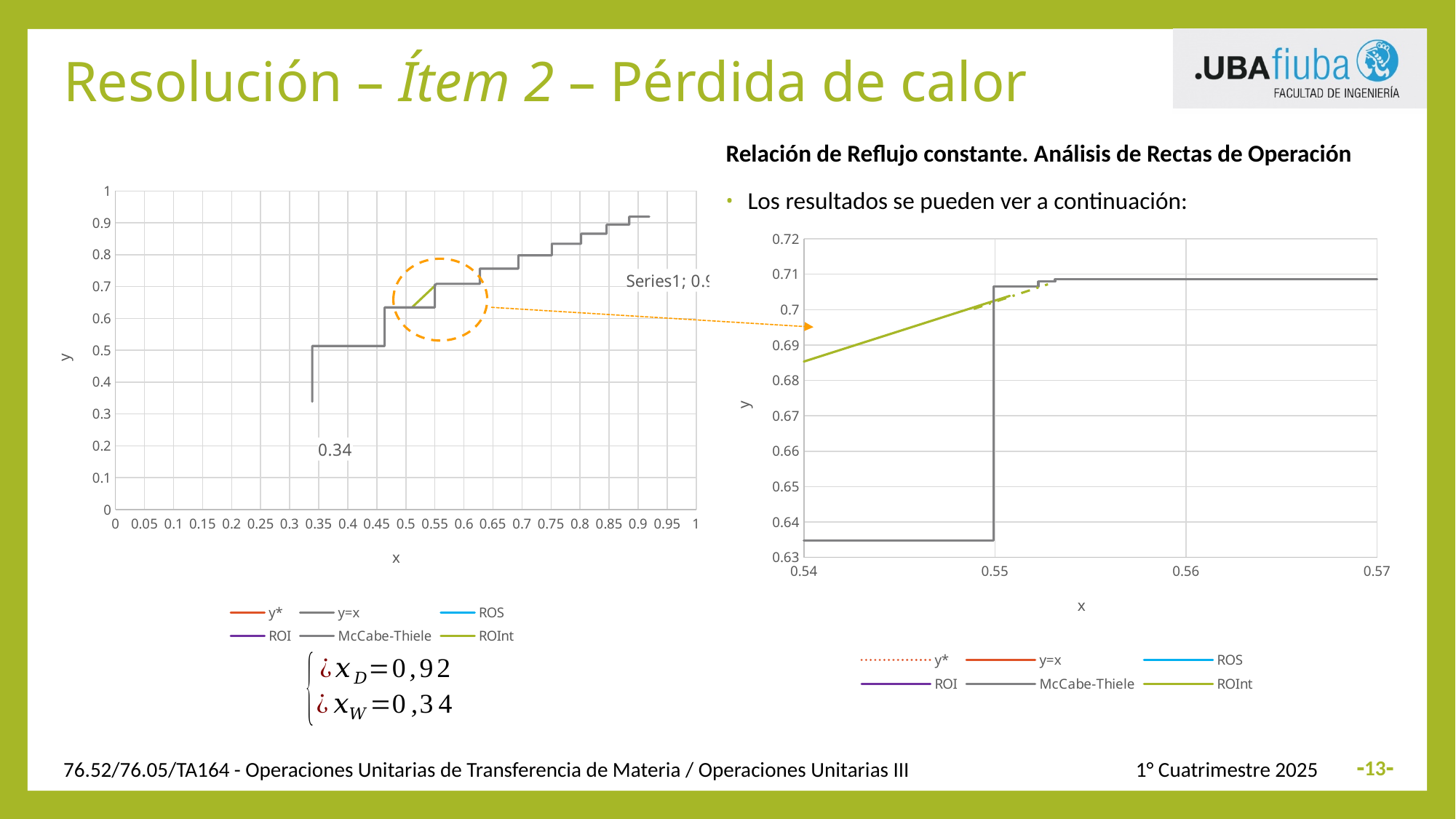
On the right chart, is the McCabe-Thiele line at x = 0.57 greater or less than 0.7? greater On the left chart, what data label is printed near the bottom of the staircase line? 0.34 How many series does the legend of the left chart list? 6 On the left chart, does the McCabe-Thiele staircase rise or fall as x increases? rise What kind of chart is the left chart on the slide? line chart How many tick labels are shown on the x axis of the right chart? 4 How many series does the legend of the right chart list? 6 Which legend entry on the left chart is drawn in green? ROInt On the right chart, is the McCabe-Thiele line at x = 0.54 greater or less than 0.64? less On the right chart, is the ROInt line at x = 0.54 greater or less than 0.68? greater What is the highest tick value on the y axis of the right chart? 0.72 What kind of chart is the right (zoomed) chart on the slide? line chart